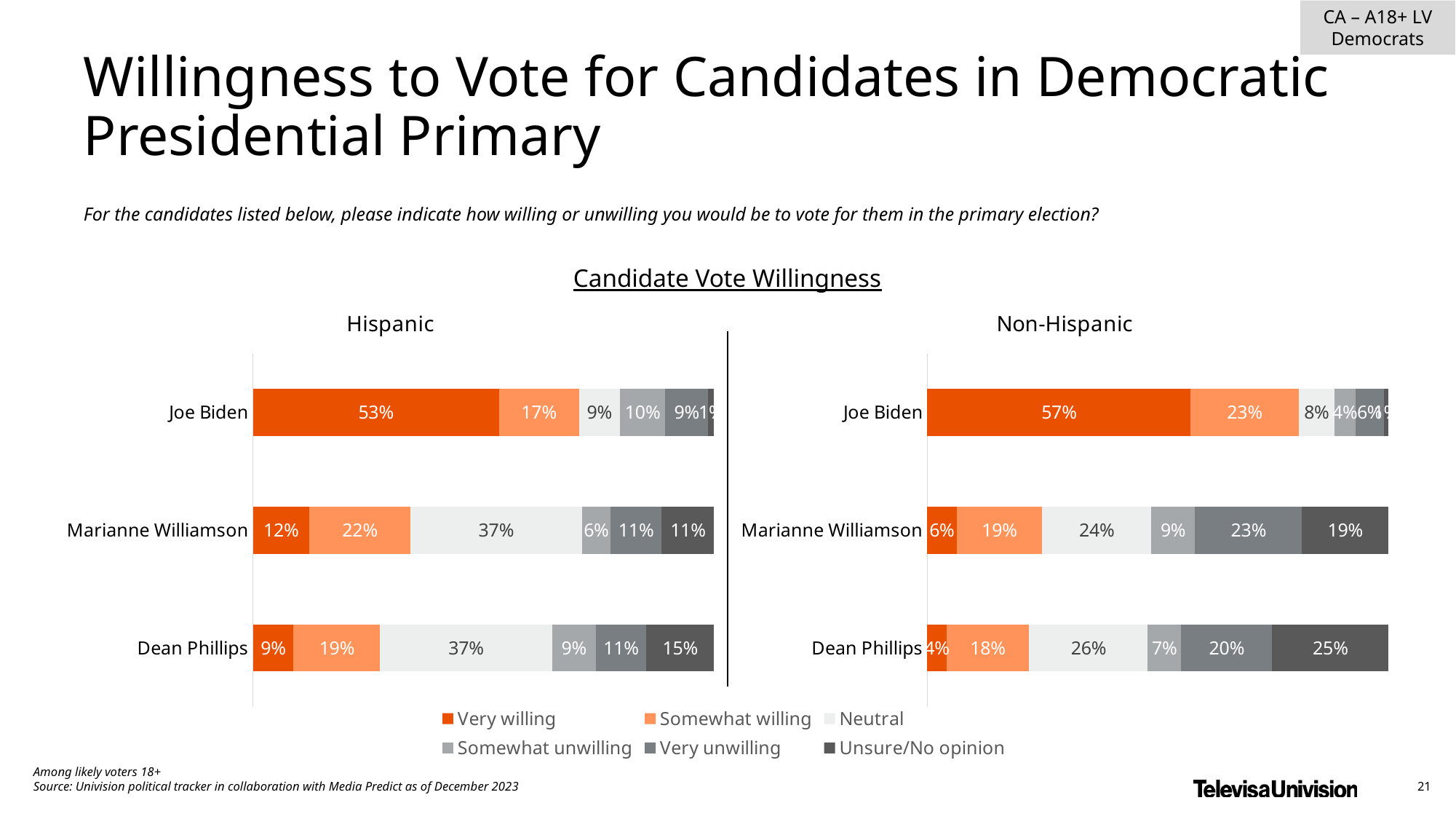
How many candidates are shown in the Hispanic chart? 3 In the Hispanic chart, what percentage of respondents are Very willing to vote for Joe Biden? 53% In the Non-Hispanic chart, what percentage of respondents are Very willing to vote for Joe Biden? 57% In the Non-Hispanic chart, which candidate has the lowest Very willing percentage? Dean Phillips In the Non-Hispanic chart, how many percentage points higher is Joe Biden's Very willing value than Marianne Williamson's? 51 percentage points In the Hispanic chart, what is the Neutral value for Marianne Williamson? 37% In the Non-Hispanic chart, what is the Unsure/No opinion value for Dean Phillips? 25% In the Hispanic chart, who has the larger Somewhat willing value, Marianne Williamson or Dean Phillips? Marianne Williamson What kind of chart is used for the Non-Hispanic data? Stacked bar chart In the Non-Hispanic chart, what is the combined Very unwilling and Unsure/No opinion percentage for Dean Phillips? 45% In the Hispanic chart, which candidate has the highest Very willing percentage? Joe Biden How many series does the legend list? 6